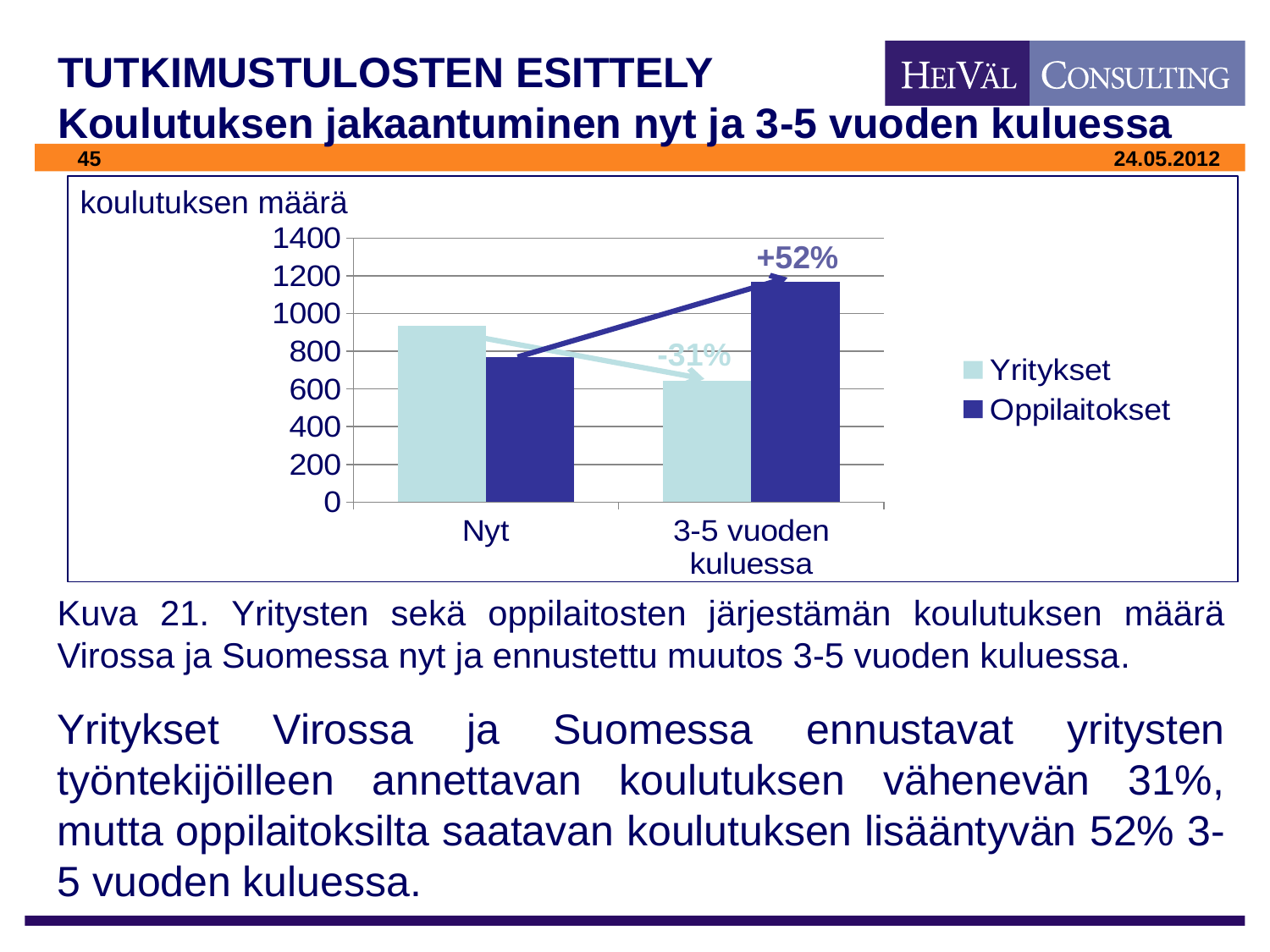
Is the value for Yritykset at 3-5 vuoden kuluessa greater or less than 800? less What kind of chart is shown on the slide? bar chart What is the label shown above the y axis of the chart? koulutuksen määrä At 3-5 vuoden kuluessa, which series has the larger value, Yritykset or Oppilaitokset? Oppilaitokset How many series does the legend list? 2 Does the Yritykset series rise or fall from Nyt to 3-5 vuoden kuluessa? fall What percentage change is labelled for the Oppilaitokset series between Nyt and 3-5 vuoden kuluessa? +52% Is the value for Oppilaitokset at 3-5 vuoden kuluessa greater or less than 1000? greater How many categories are shown on the x axis? 2 What percentage change is labelled for the Yritykset series between Nyt and 3-5 vuoden kuluessa? -31% At Nyt, which series has the larger value, Yritykset or Oppilaitokset? Yritykset Is the value for Yritykset at Nyt greater or less than 800? greater